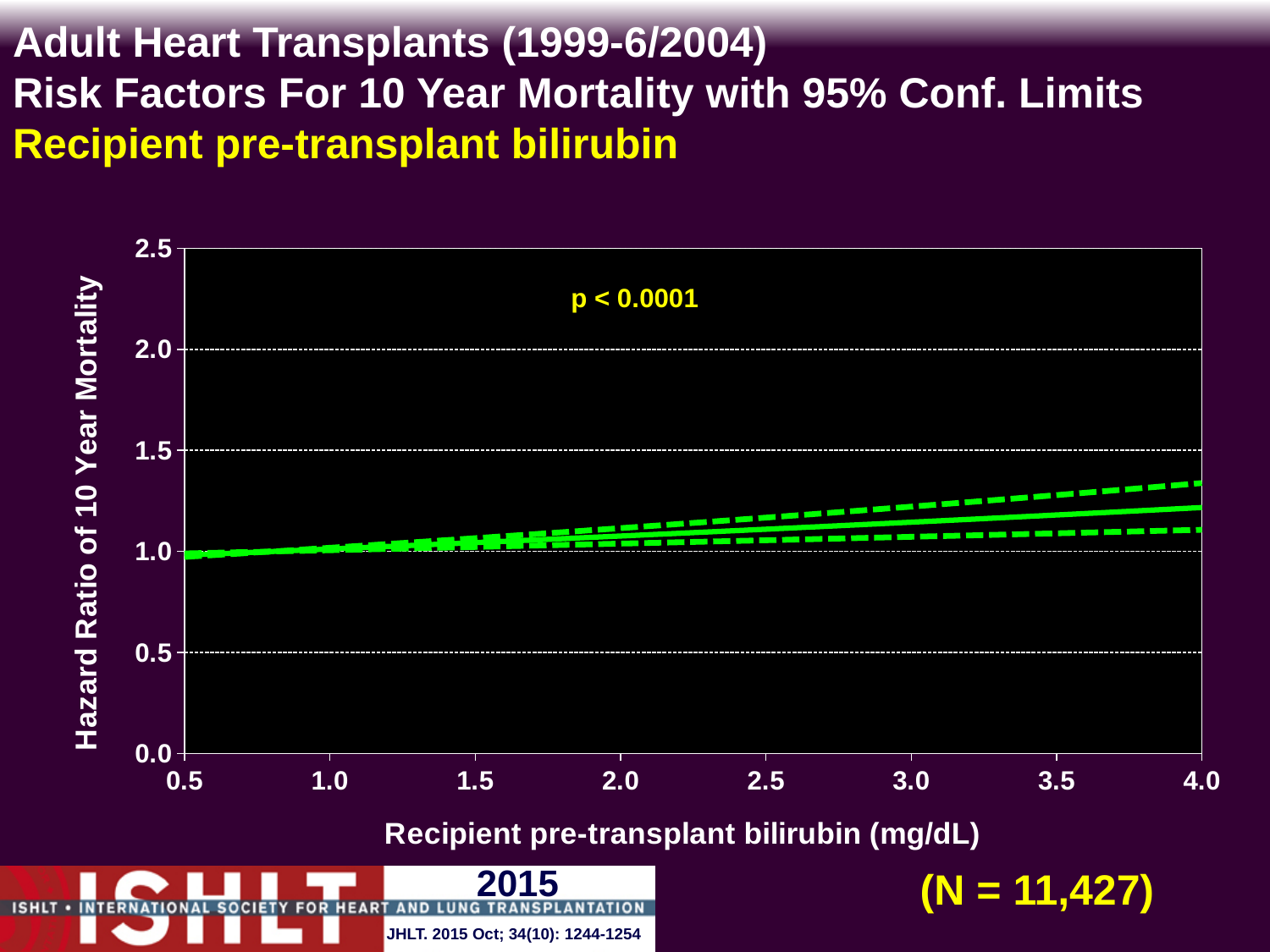
What is the label of the x axis of the chart? Recipient pre-transplant bilirubin (mg/dL) Is the hazard ratio (solid line) at a bilirubin of 2.0 mg/dL greater or less than 2.0? less What is the highest value shown on the y axis of the chart? 2.5 Is the hazard ratio (solid line) at a bilirubin of 0.5 mg/dL greater or less than 1.5? less Does the hazard ratio of 10 year mortality rise or fall as recipient pre-transplant bilirubin increases from 0.5 to 4.0 mg/dL? rise How many lines are plotted on the chart (including the confidence limit lines)? 3 Is the hazard ratio (solid line) at a bilirubin of 4.0 mg/dL greater or less than 1.0? greater What kind of chart is shown on the slide? line chart